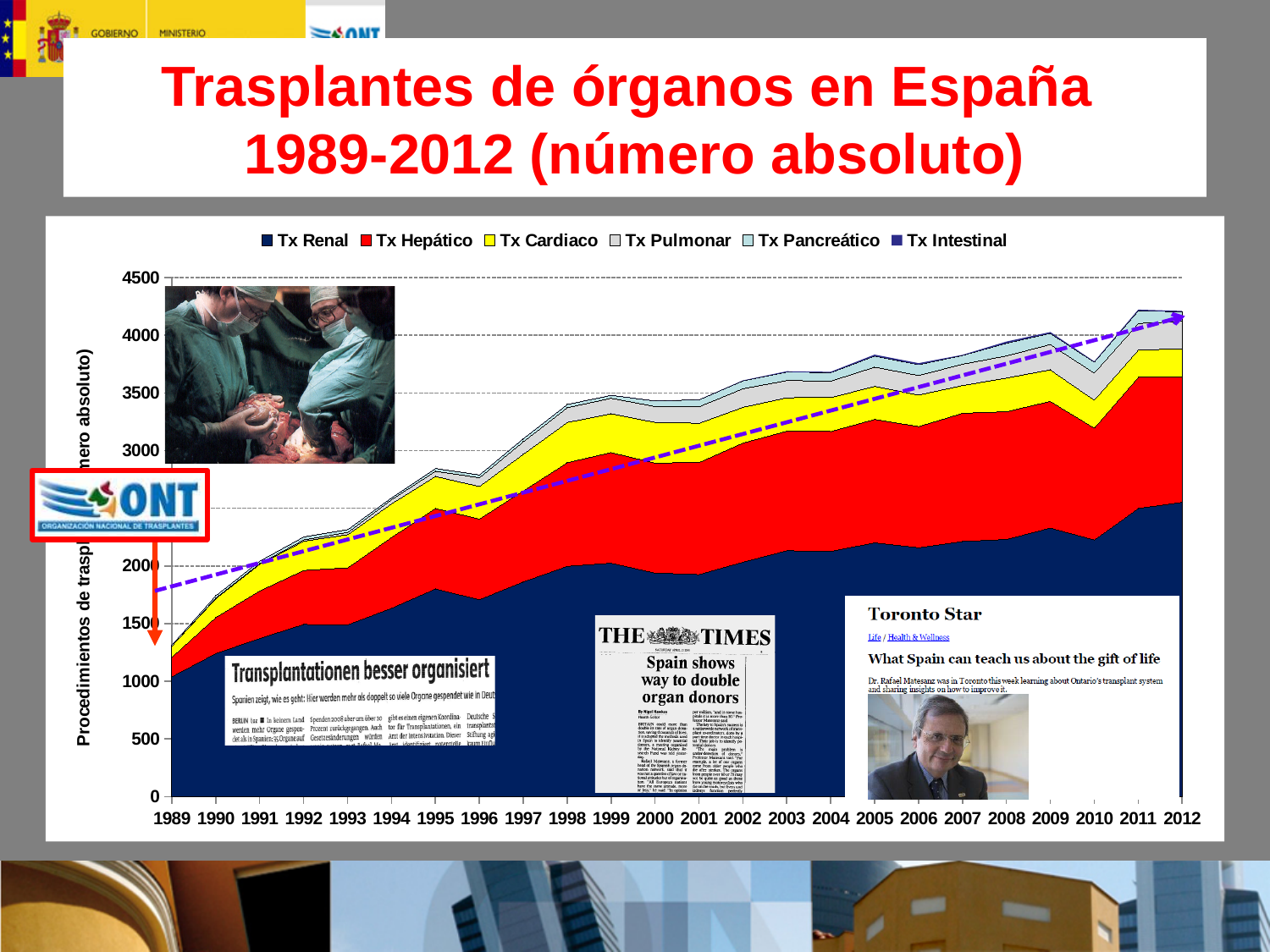
What kind of chart is shown on the slide? Stacked area chart Is the total number of transplants in 2012 greater or less than 4000? greater Is the total number of transplants in 1989 greater or less than 1500? less Is the total number of transplants in 2000 greater or less than 3000? greater What is the first year shown on the x axis? 1989 What is the last year shown on the x axis? 2012 Which series is the largest contributor to the total in every year? Tx Renal How many years are shown along the x axis? 24 How many series does the legend list? 6 Which year has the highest total number of transplants? 2011 Does the total number of transplants generally rise or fall from 1989 to 2012? Rise